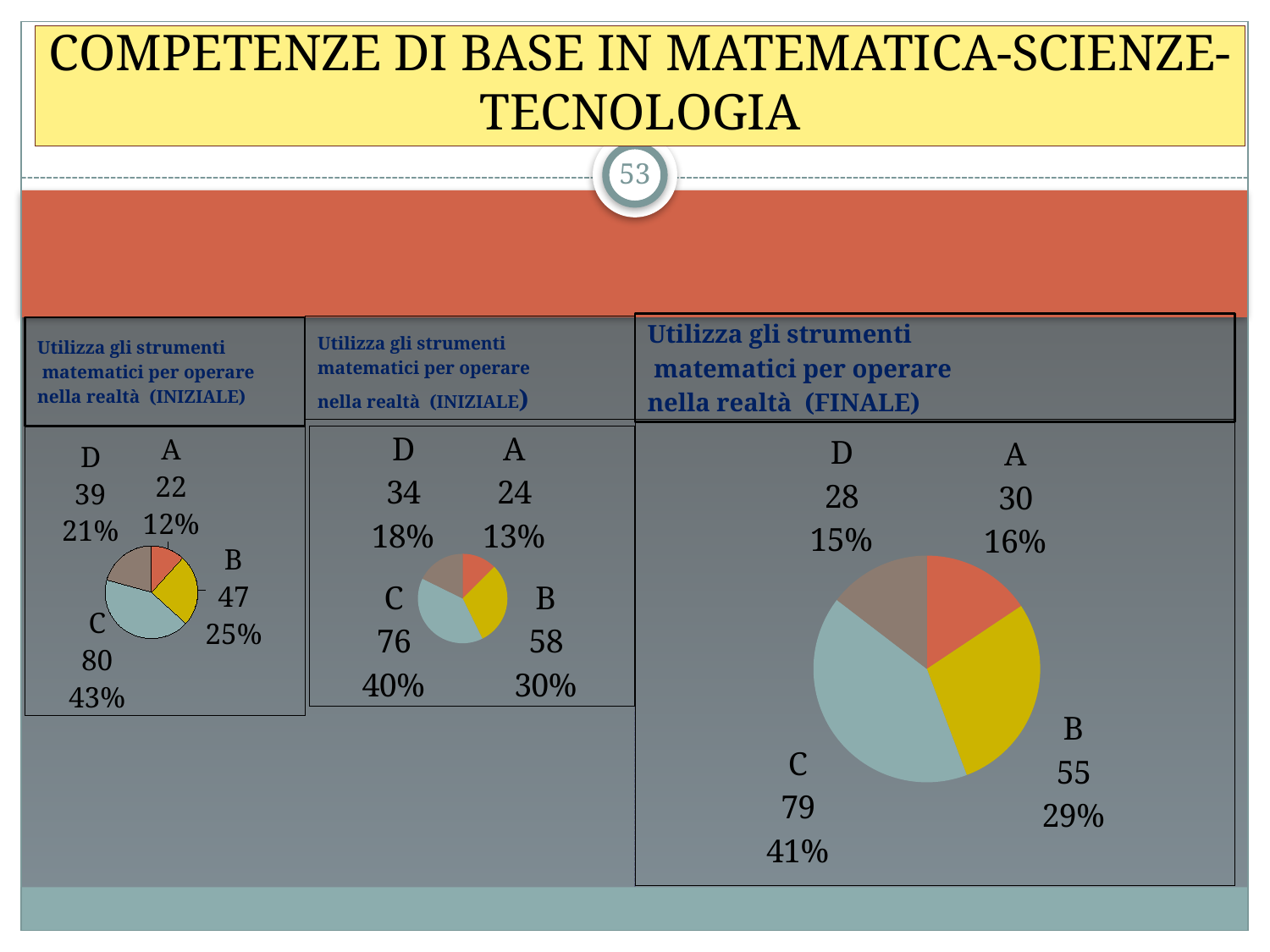
In the right pie chart (FINALE), what share of the pie does category C represent? 41% In the right pie chart (FINALE), which is larger, the value for A or the value for D? A In the left pie chart (INIZIALE), what share of the pie does category B represent? 25% In the middle pie chart (INIZIALE), what share of the pie does category D represent? 18% How many categories does the right pie chart (FINALE) show? 4 In the right pie chart (FINALE), what is the value for category A? 30 In the middle pie chart (INIZIALE), which category has the highest value? C In the left pie chart (INIZIALE), which category has the lowest value? A In the right pie chart (FINALE), what is the difference between the values for C and B? 24 In the middle pie chart (INIZIALE), what is the value for category B? 58 In the left pie chart (INIZIALE), what is the value for category C? 80 What type of chart is used on this slide? Pie chart